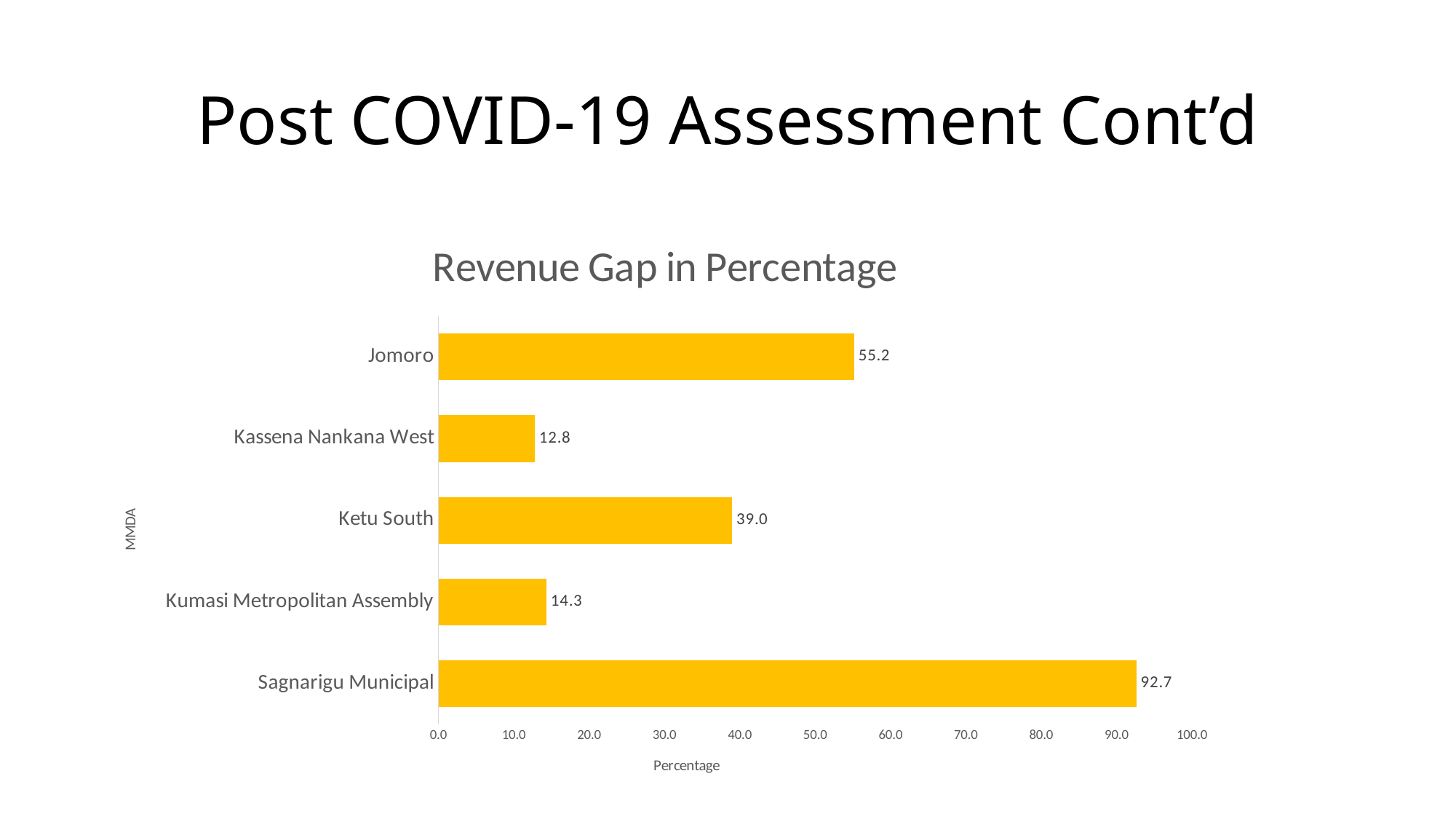
What is the revenue gap percentage for Kassena Nankana West? 12.8 What type of chart is shown on the slide? Bar chart What is the revenue gap percentage for Kumasi Metropolitan Assembly? 14.3 What is the revenue gap percentage for Ketu South? 39.0 Which MMDA has the highest revenue gap percentage? Sagnarigu Municipal What is the revenue gap percentage for Jomoro? 55.2 Is the value for Sagnarigu Municipal greater or less than 90.0? greater How many MMDAs are shown in the chart? 5 What is the title of the chart? Revenue Gap in Percentage What is the difference between the revenue gap percentages of Sagnarigu Municipal and Jomoro? 37.5 Which MMDA has the lowest revenue gap percentage? Kassena Nankana West Which has a larger revenue gap percentage, Ketu South or Jomoro? Jomoro